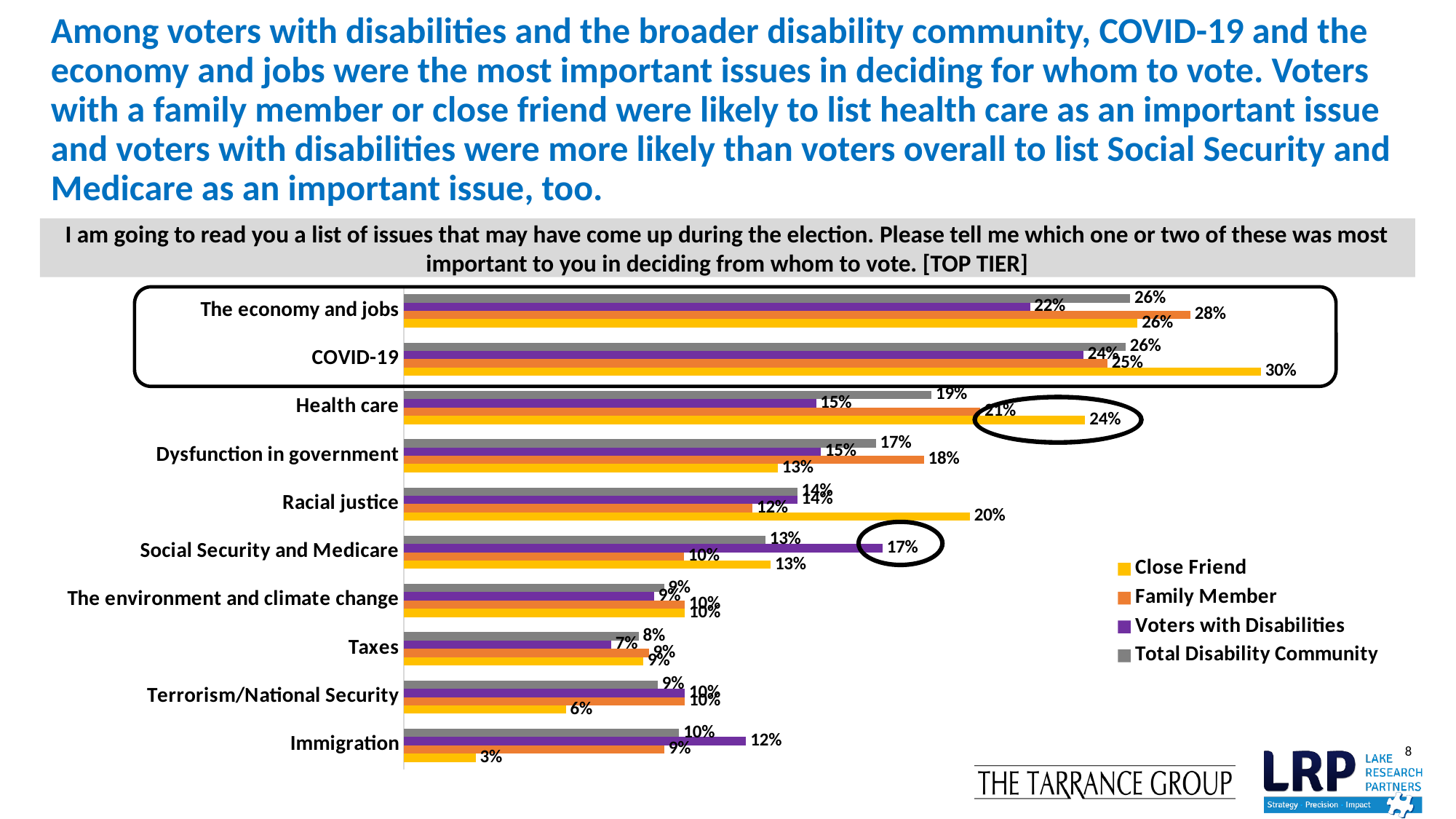
What is the Family Member value for The economy and jobs? 28% Which issue has the highest Close Friend value? COVID-19 Which series is shown in yellow in the legend? Close Friend What is the Voters with Disabilities value for Social Security and Medicare? 17% Which issue has the lowest Close Friend value? Immigration What is the difference between the Close Friend and Voters with Disabilities values for Health care? 9% How many issues are listed on the chart? 10 What is the Close Friend value for Immigration? 3% What percentage of Close Friend respondents listed COVID-19 as a most important issue? 30% How many series does the legend list? 4 For Racial justice, which is larger: the Close Friend value or the Family Member value? Close Friend What kind of chart is shown on the slide? Bar chart